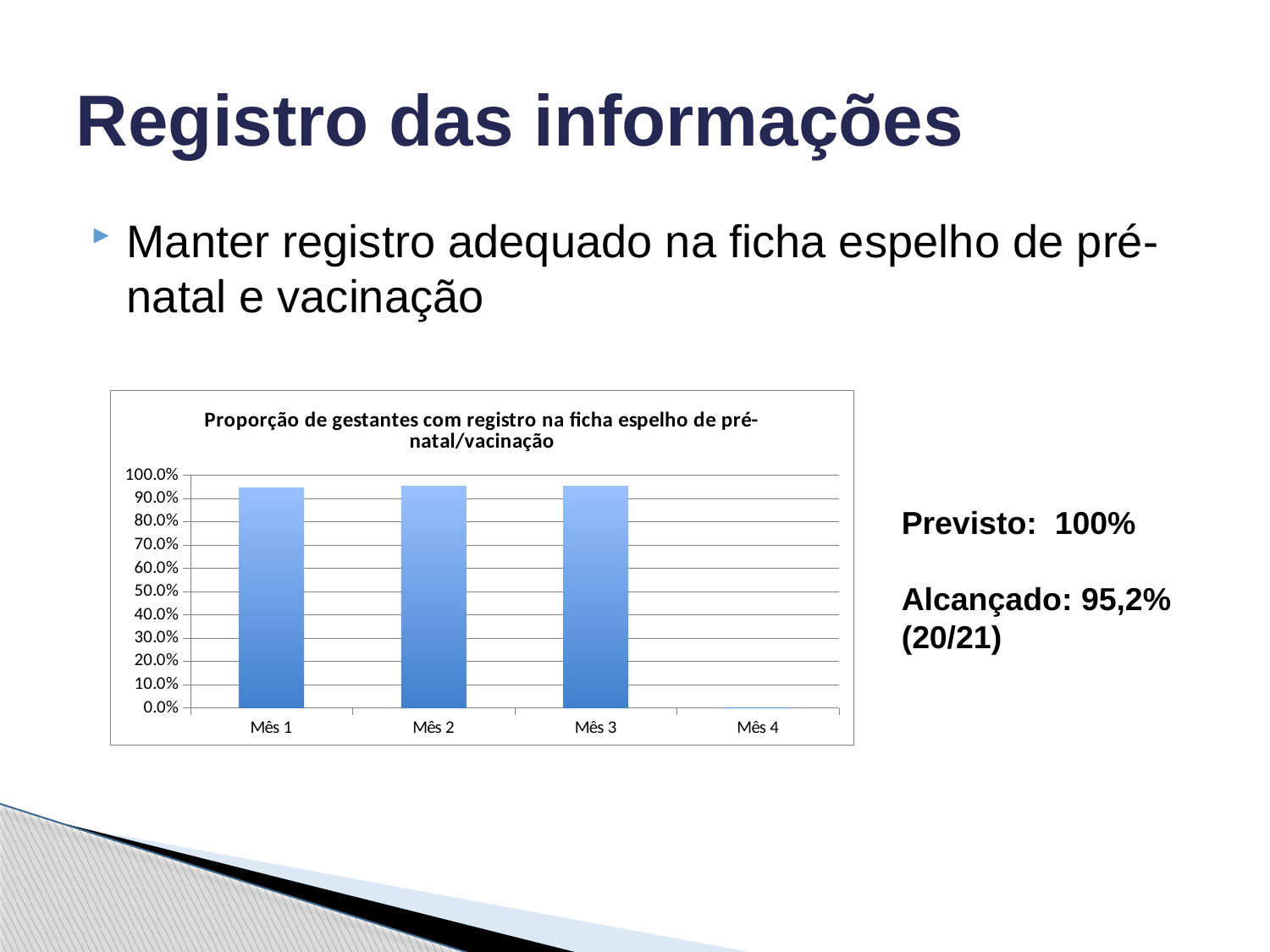
What is the title of the chart? Proporção de gestantes com registro na ficha espelho de pré-natal/vacinação What kind of chart is shown on the slide? bar chart Does the value rise or fall from Mês 3 to Mês 4? fall Is the value for Mês 4 greater or less than 10.0%? less Is the value for Mês 1 greater or less than 90.0%? greater Which is larger, the value for Mês 4 or the value for Mês 1? Mês 1 Is the value for Mês 2 greater or less than 100.0%? less Which category has the lowest value in the chart? Mês 4 How many categories are shown on the x axis of the chart? 4 Which is larger, the value for Mês 2 or the value for Mês 4? Mês 2 What is the label of the first category on the x axis? Mês 1